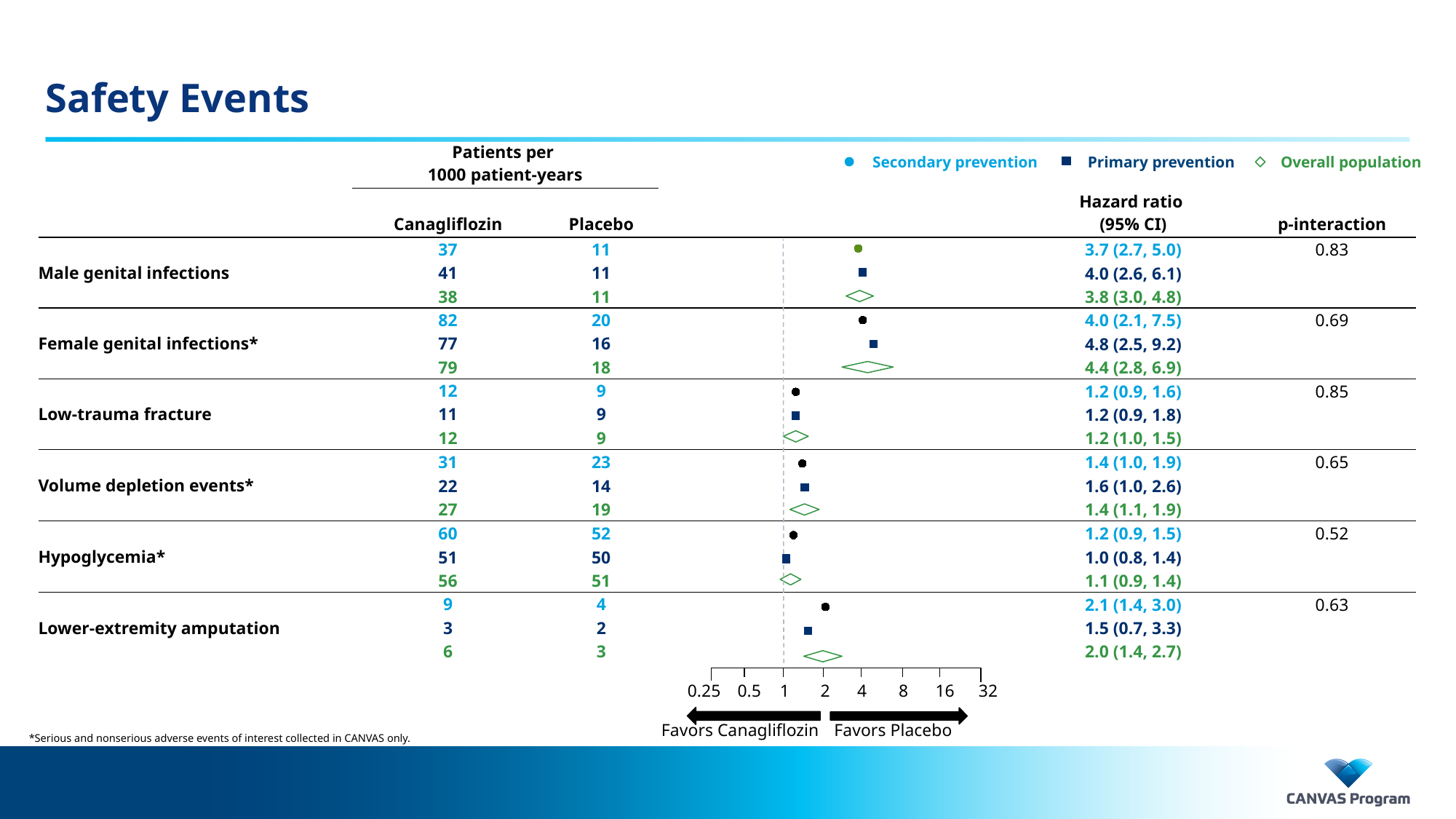
Which safety event has the lowest overall-population hazard ratio? Hypoglycemia How many patients per 1000 patient-years had lower-extremity amputation on canagliflozin in the secondary prevention group? 9 What is the p-interaction value for hypoglycemia? 0.52 Which safety event has the highest overall-population hazard ratio? Female genital infections What is the hazard ratio (95% CI) for female genital infections in the primary prevention group? 4.8 (2.5, 9.2) How many safety events are listed in the forest plot? 6 Which is larger: the primary prevention hazard ratio for male genital infections or for lower-extremity amputation? Male genital infections What does the right-pointing arrow below the x axis indicate? Favors Placebo Is the overall-population hazard ratio for volume depletion events greater or less than 1? greater How many series does the legend list? 3 What is the hazard ratio (95% CI) for male genital infections in the overall population? 3.8 (3.0, 4.8) What is the difference between the canagliflozin and placebo rates per 1000 patient-years for female genital infections in the overall population? 61